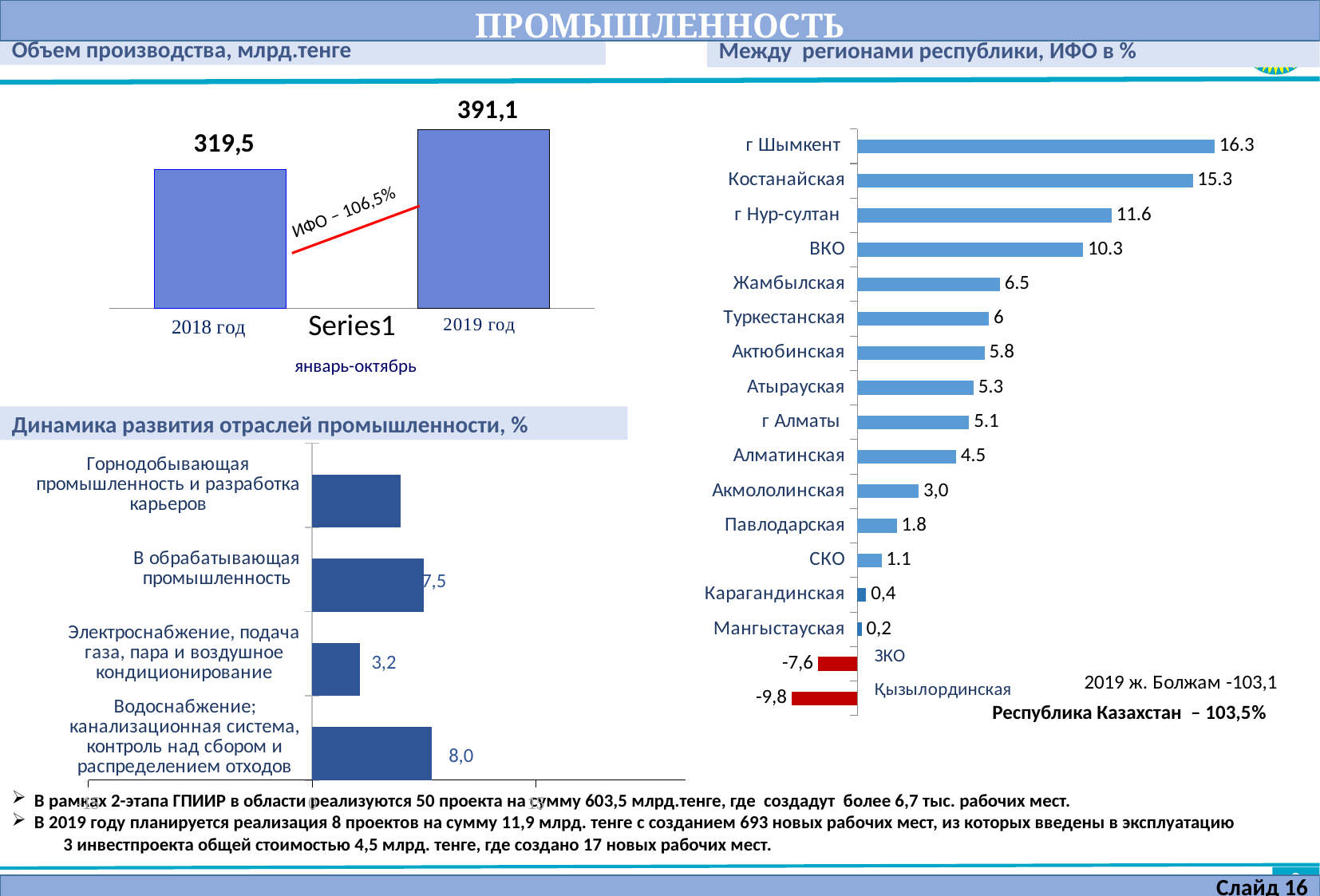
In the chart 'Объем производства, млрд.тенге', what is the value for 2018 год? 319,5 In the chart 'Между регионами республики, ИФО в %', how many regions are plotted? 17 In the chart 'Объем производства, млрд.тенге', what kind of chart is used? bar chart In the chart 'Динамика развития отраслей промышленности, %', which is larger, the value for 'Электроснабжение, подача газа, пара и воздушное кондиционирование' or the value for 'Водоснабжение; канализационная система, контроль над сбором и распределением отходов'? Водоснабжение; канализационная система, контроль над сбором и распределением отходов In the chart 'Между регионами республики, ИФО в %', what is the value for ЗКО? -7,6 In the chart 'Объем производства, млрд.тенге', what is the value for 2019 год? 391,1 In the chart 'Между регионами республики, ИФО в %', which region has the highest value? г Шымкент In the chart 'Объем производства, млрд.тенге', what is the difference between the 2019 год and 2018 год values? 71,6 In the chart 'Между регионами республики, ИФО в %', which is larger, the value for Костанайская or the value for г Нур-султан? Костанайская In the chart 'Между регионами республики, ИФО в %', which region has the lowest value? Қызылординская In the chart 'Динамика развития отраслей промышленности, %', what is the value for 'В обрабатывающая промышленность'? 7,5 In the chart 'Между регионами республики, ИФО в %', what is the value for ВКО? 10.3